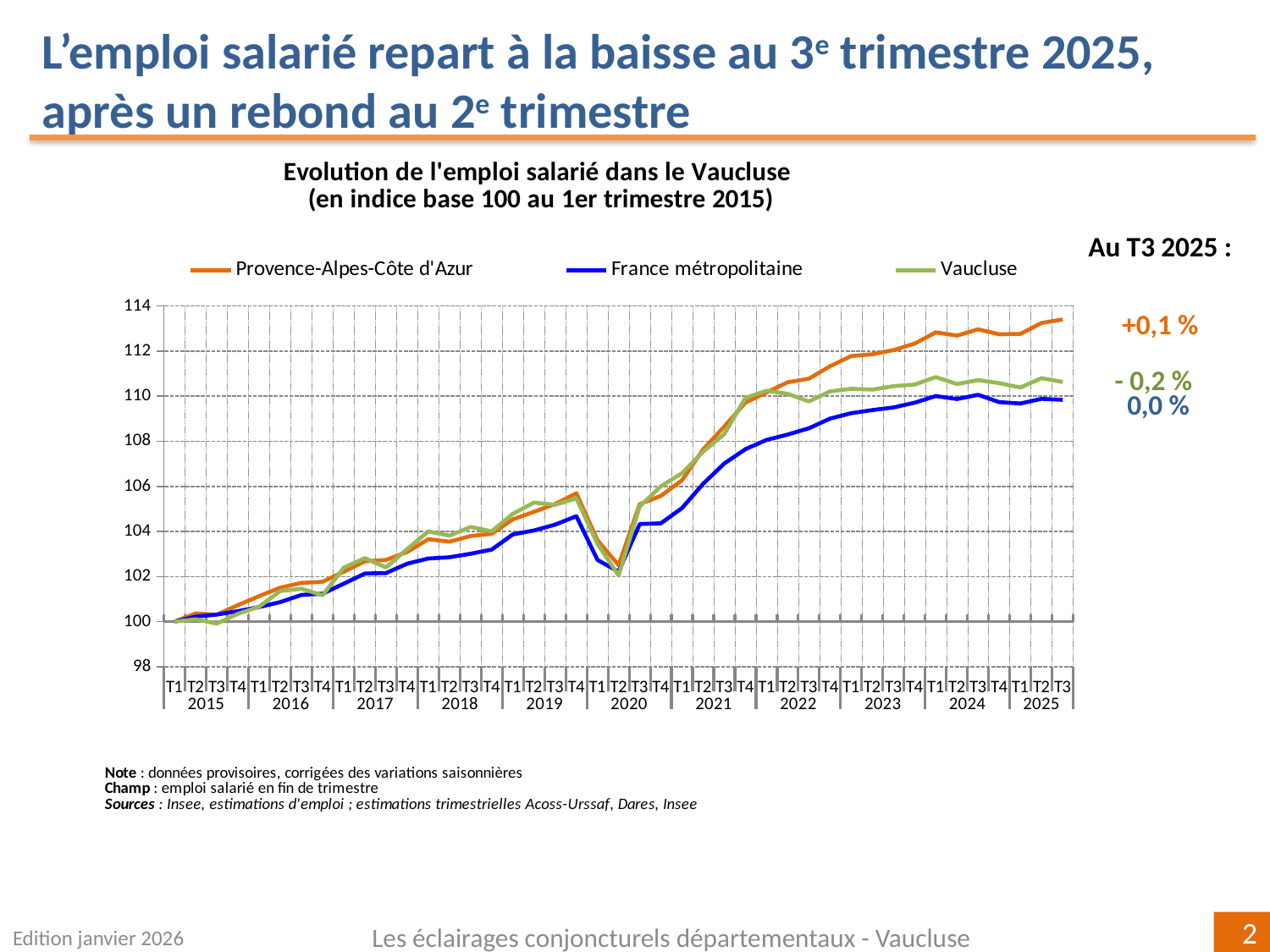
Is the value for Provence-Alpes-Côte d'Azur at T3 2025 greater or less than 112? greater What is the index value for Vaucluse at T1 2015? 100 Overall, do the values rise or fall from 2015 to 2025? rise Which series has the highest value at T3 2025? Provence-Alpes-Côte d'Azur Is the value for Vaucluse at T2 2020 greater or less than 104? less Which series has the lowest value at T3 2025? France métropolitaine What kind of chart is shown on the slide? line chart How many years are labelled on the x axis? 11 At T3 2025, which is larger: the value for Provence-Alpes-Côte d'Azur or the value for Vaucluse? Provence-Alpes-Côte d'Azur Which series are listed in the legend? Provence-Alpes-Côte d'Azur, France métropolitaine, Vaucluse How many series does the legend list? 3 What is the title of the chart? Evolution de l'emploi salarié dans le Vaucluse (en indice base 100 au 1er trimestre 2015)